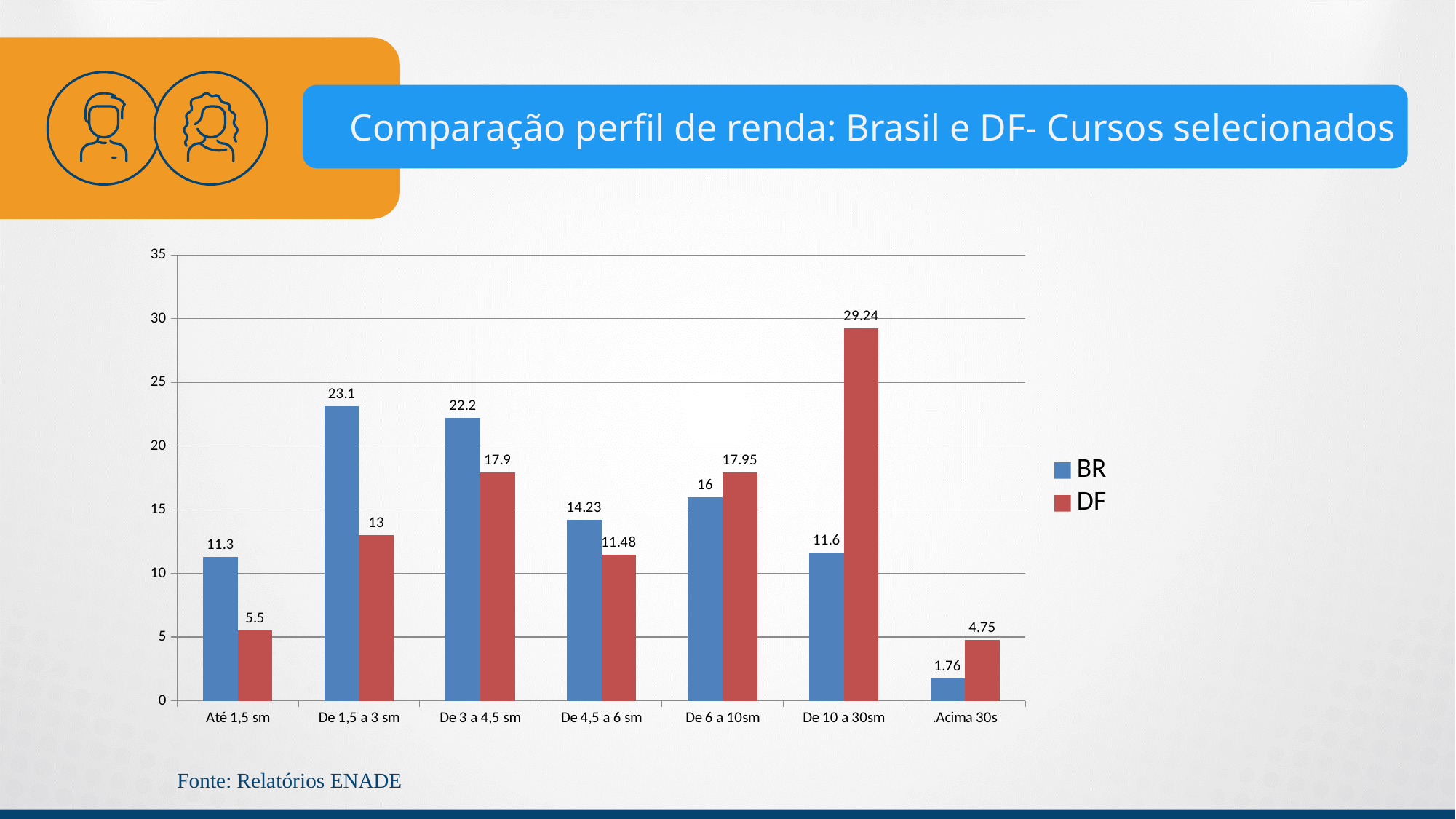
What is the title of the chart on the slide? Comparação perfil de renda: Brasil e DF- Cursos selecionados Is the BR value for 'De 6 a 10sm' greater or less than 20? less What is the DF value for the 'Até 1,5 sm' category? 5.5 What is the difference between the DF and BR values for 'De 10 a 30sm'? 17.64 Which is larger for 'De 3 a 4,5 sm', the BR value or the DF value? BR Which category has the lowest BR value? .Acima 30s What is the BR value for the 'De 1,5 a 3 sm' category? 23.1 What is the DF value for the 'De 10 a 30sm' category? 29.24 Which category has the highest DF value? De 10 a 30sm What kind of chart is shown on the slide? Bar chart How many series does the legend list? 2 How many income categories are shown on the x axis? 7